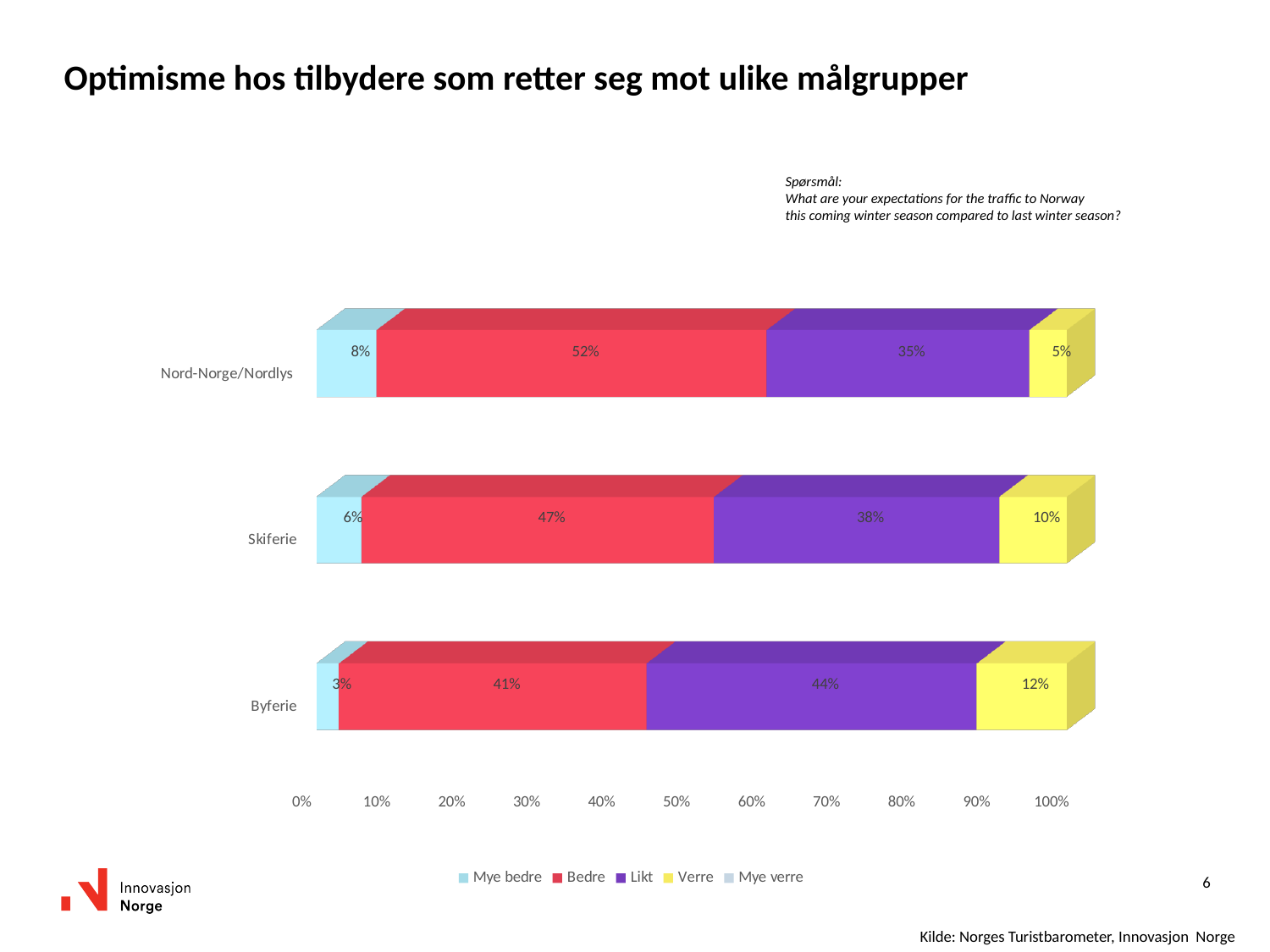
What is the total of the labelled segments in the Nord-Norge/Nordlys bar? 100% How many categories (target groups) are shown on the chart? 3 What is the 'Bedre' value for Nord-Norge/Nordlys? 52% How many series does the legend list? 5 Which category has the highest 'Bedre' value? Nord-Norge/Nordlys What kind of chart is shown on the slide? Stacked bar chart What is the 'Mye bedre' value for Byferie? 3% Which is larger: the 'Likt' value for Skiferie or the 'Likt' value for Nord-Norge/Nordlys? Skiferie Which category has the lowest 'Mye bedre' value? Byferie What is the 'Verre' value for Skiferie? 10% What is the difference between the 'Verre' values for Byferie and Nord-Norge/Nordlys? 7% What is the 'Likt' value for Byferie? 44%